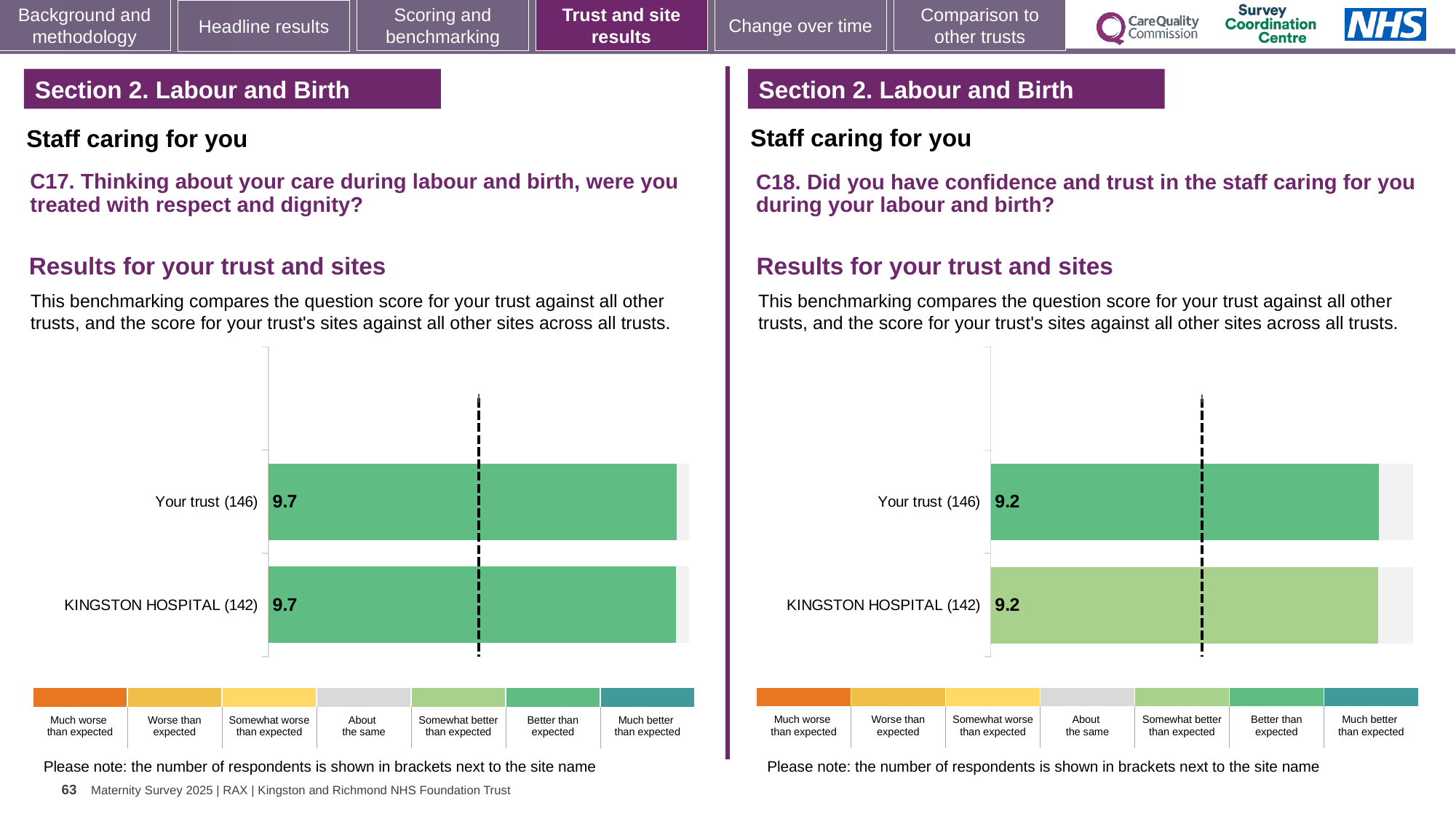
Is the Your trust score in the C17 chart on the left larger than, smaller than, or equal to the Your trust score in the C18 chart on the right? Larger In the C18 chart on the right, which benchmarking category does the colour of the KINGSTON HOSPITAL bar correspond to? Somewhat better than expected In the C17 chart on the left, what is the score for Your trust? 9.7 In the C18 chart on the right, what is the score for KINGSTON HOSPITAL? 9.2 In the C18 chart on the right, what is the difference between the Your trust score and the KINGSTON HOSPITAL score? 0 How many bars are plotted in the C17 chart on the left? 2 In the C17 chart on the left, what is the score for KINGSTON HOSPITAL? 9.7 In the C17 chart on the left, how many respondents are shown in brackets for KINGSTON HOSPITAL? 142 In the C18 chart on the right, what is the score for Your trust? 9.2 What type of chart is used for the C18 results on the right? Bar chart In the C17 chart on the left, what is the difference between the Your trust score and the KINGSTON HOSPITAL score? 0 How many bars are plotted in the C18 chart on the right? 2